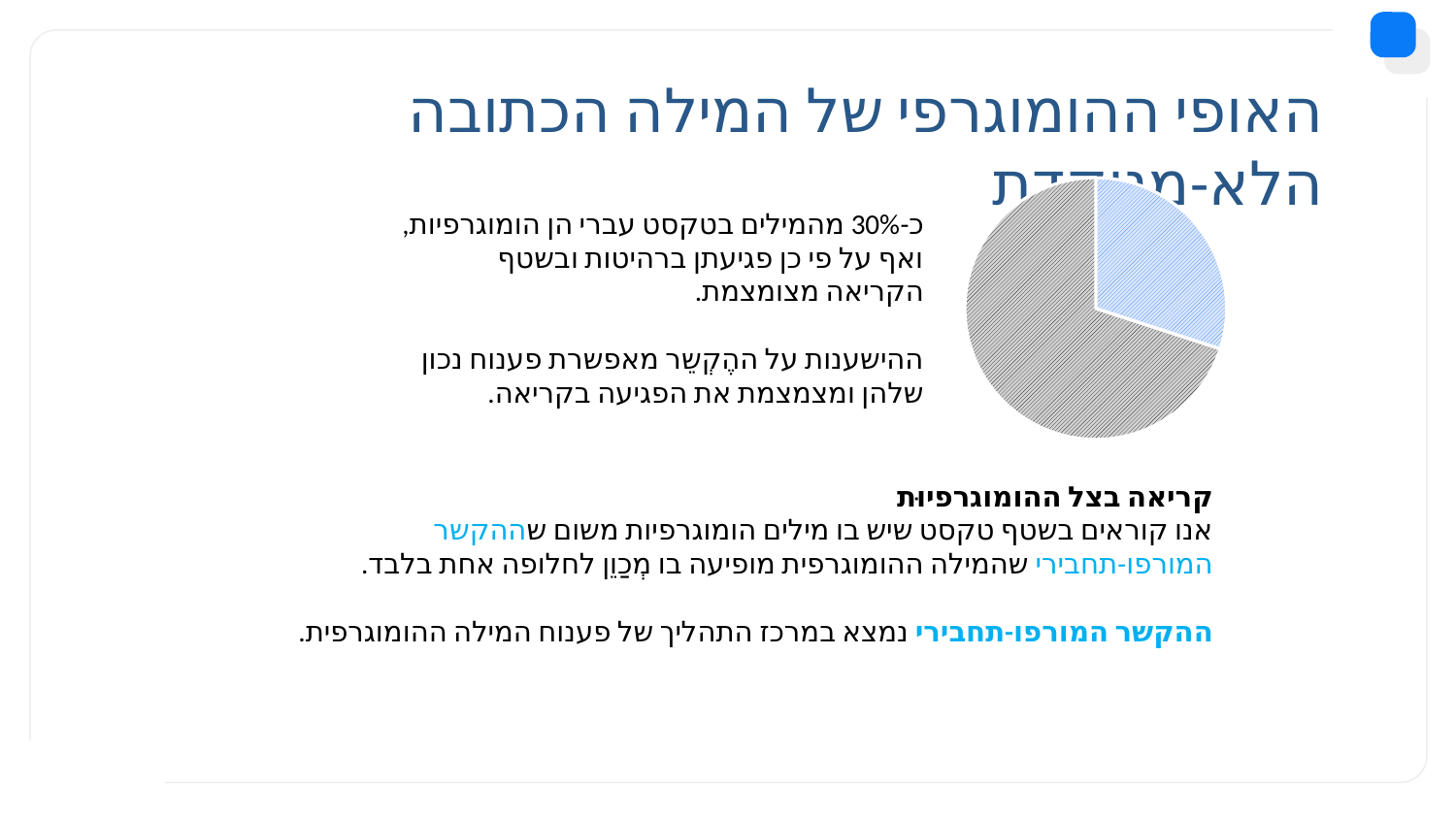
What kind of chart is shown on the slide? pie chart Does the blue slice of the pie chart cover more or less than half of the pie? less Which slice of the pie chart is larger, the gray hatched slice or the blue slice? the gray hatched slice Does the pie chart show a legend? No Which slice of the pie chart is the smallest? the blue slice What colour is the larger slice of the pie chart? gray (hatched) How many slices does the pie chart have? 2